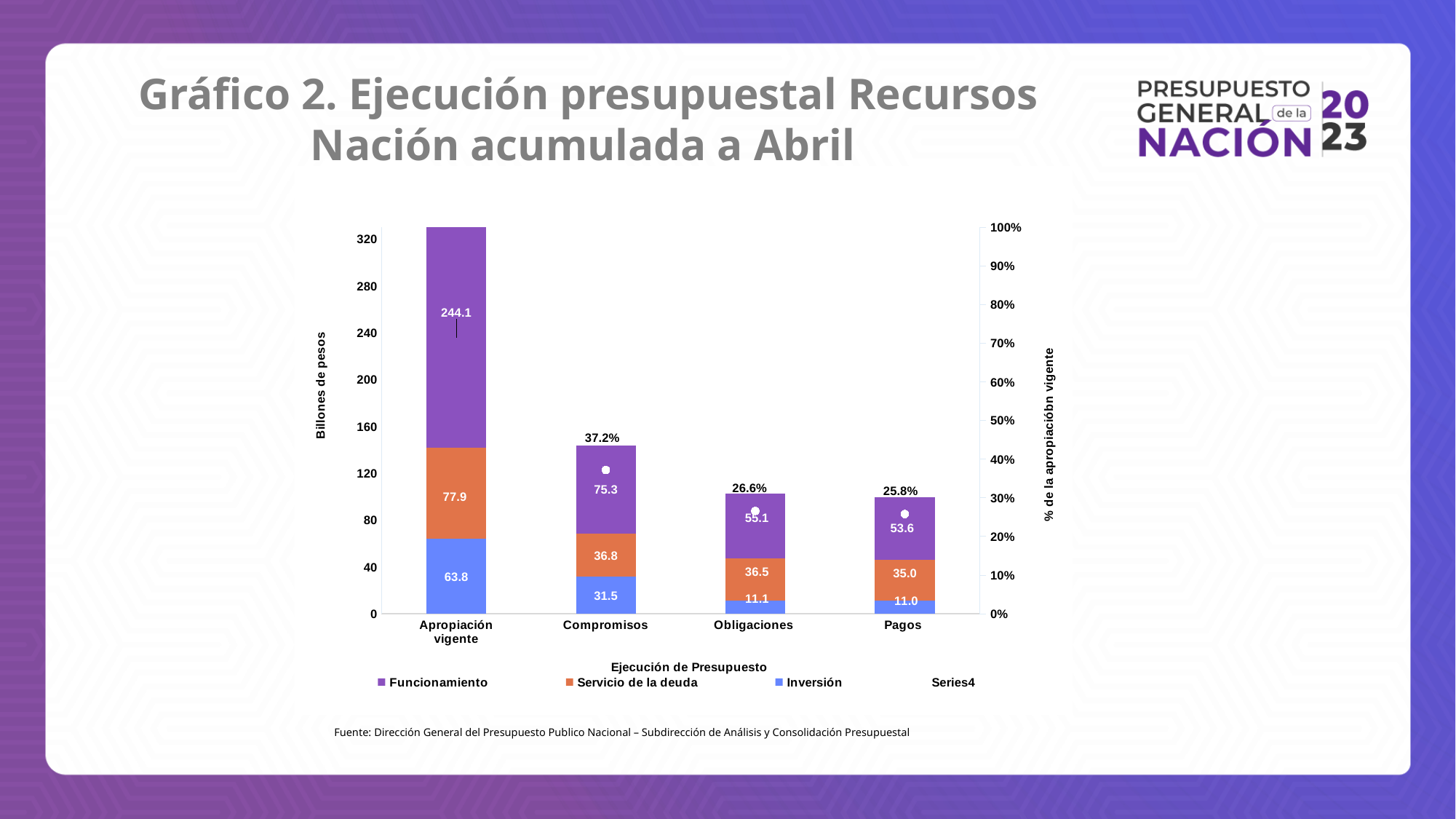
What is the value of Servicio de la deuda for Compromisos? 36.8 Which category has the highest Funcionamiento value? Apropiación vigente What is the total of the stacked bar for Compromisos? 143.6 Which category has the lowest Inversión value? Pagos What is the difference between the Funcionamiento values for Compromisos and Obligaciones? 20.2 What is the value of Inversión for Pagos? 11.0 How many categories are shown on the x axis? 4 Which is larger, the Servicio de la deuda value for Obligaciones or for Pagos? Obligaciones What is the value of Funcionamiento for Apropiación vigente? 244.1 What kind of chart is shown on the slide? Stacked bar chart What percentage of the apropiación vigente is shown for Obligaciones? 26.6% How many series does the legend list? 4